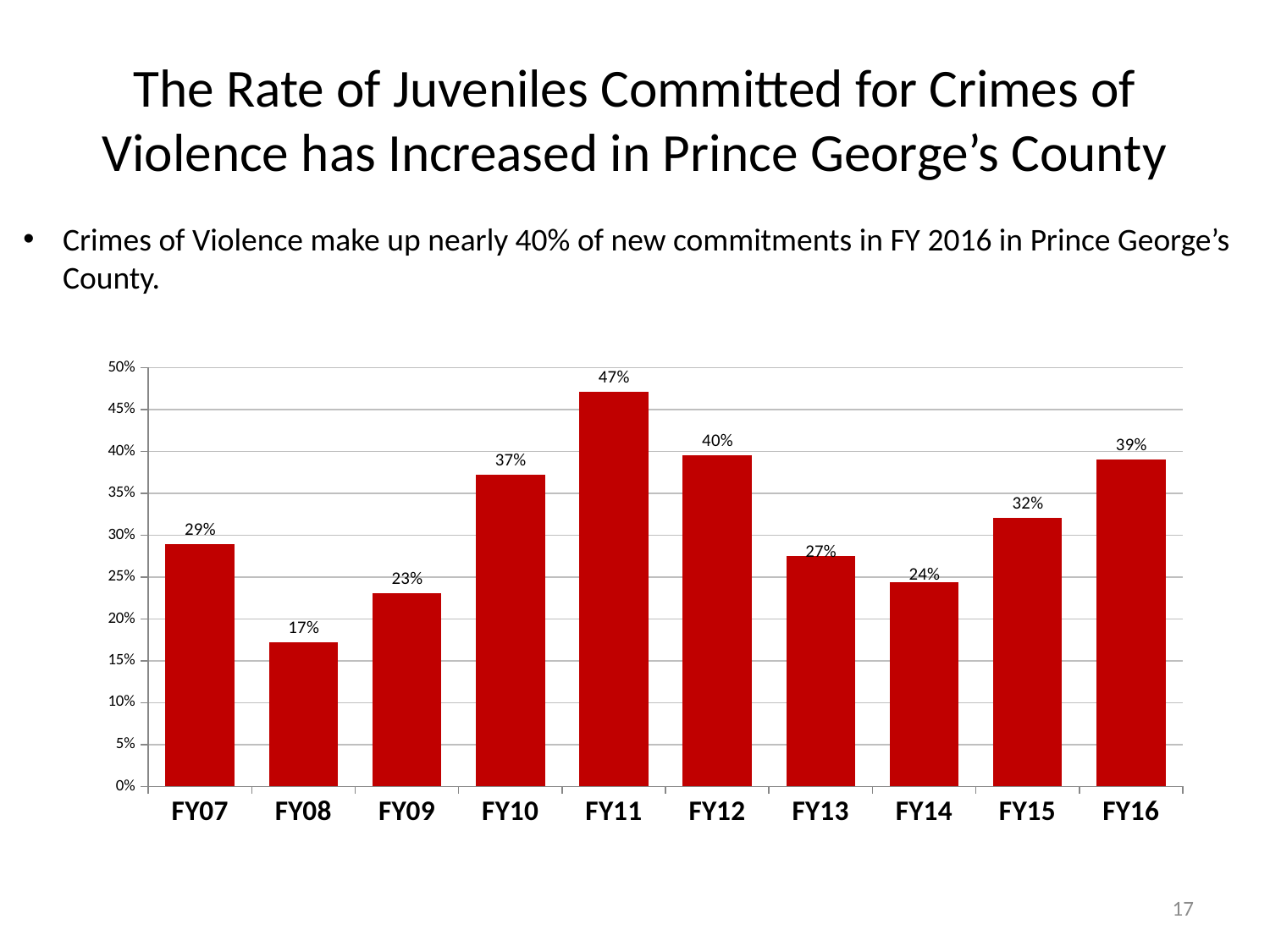
Which fiscal year has the lowest value? FY08 What kind of chart is shown on the slide? Bar chart What is the value for FY16? 39% What is the value for FY11? 47% Is the value for FY13 greater or less than 25%? greater What is the difference between the values for FY16 and FY07? 10% Which fiscal year has the highest value? FY11 What is the value for FY08? 17% How many fiscal years are shown on the x axis? 10 What is the difference between the values for FY11 and FY08? 30% Do the values rise or fall from FY13 to FY16? Neither consistently; they fall from FY13 (27%) to FY14 (24%), then rise to FY15 (32%) and FY16 (39%) Which is larger, the value for FY10 or the value for FY15? FY10